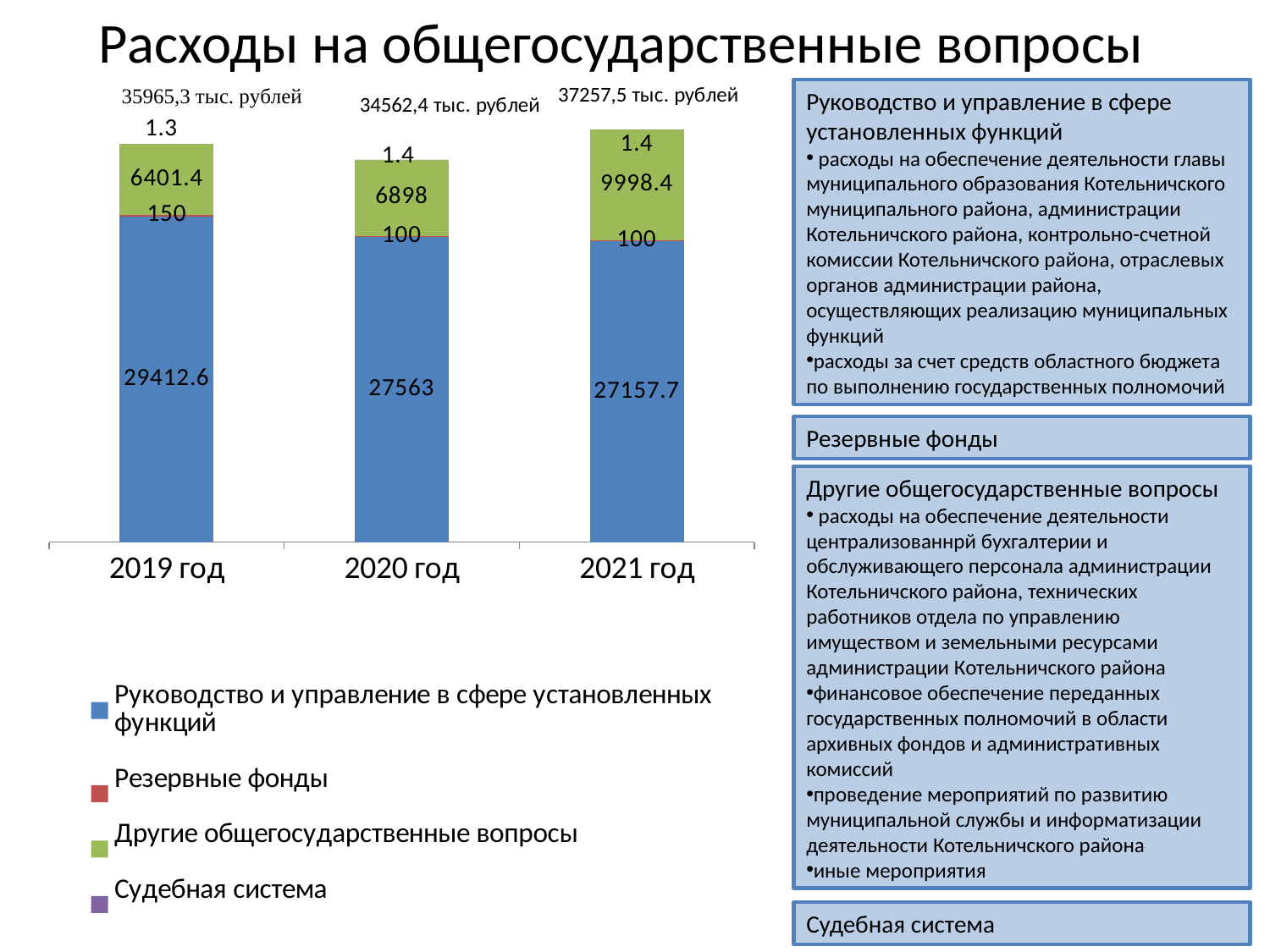
What is the value of 'Другие общегосударственные вопросы' for 2021 год? 9998.4 Which year has the lowest value for 'Руководство и управление в сфере установленных функций'? 2021 год What is the value of 'Руководство и управление в сфере установленных функций' for 2019 год? 29412.6 What is the value of 'Судебная система' for 2019 год? 1.3 What is the total shown above the stacked bar for 2021 год? 37257,5 тыс. рублей What is the value of 'Резервные фонды' for 2020 год? 100 Which is larger: 'Резервные фонды' in 2019 год or in 2021 год? 2019 год How many categories (years) are shown on the x axis of the chart? 3 How many series does the chart legend list? 4 What is the difference between the 'Другие общегосударственные вопросы' values for 2021 год and 2020 год? 3100.4 Which year has the highest value for 'Другие общегосударственные вопросы'? 2021 год What type of chart is shown on the slide? stacked bar chart